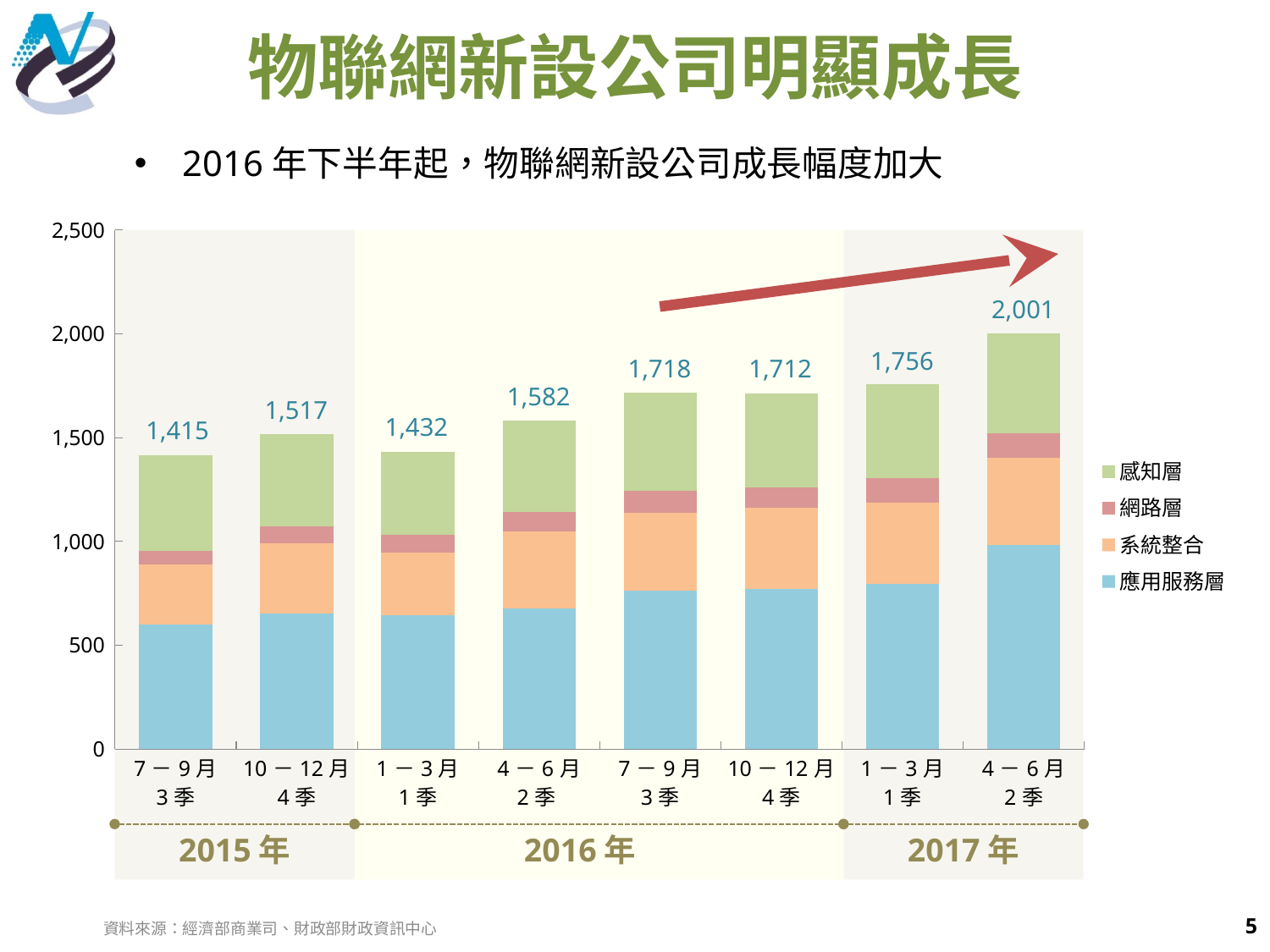
Which quarter has the highest total value? 2017 年 2 季 (4－6月) Which quarter has the lowest total value? 2015 年 3 季 (7－9月) Is the 應用服務層 value for 2015 年 3 季 (7－9月) greater or less than 500? greater What is the difference between the total for 2017 年 2 季 and the total for 2017 年 1 季? 245 What kind of chart is shown on the slide? Stacked bar chart How many quarterly bars are shown in the chart? 8 What is the total value labelled for the 2017 年 2 季 (4－6月) bar? 2,001 How many series does the legend list? 4 Which is larger, the total for 2016 年 3 季 (7－9月) or the total for 2016 年 4 季 (10－12月)? 2016 年 3 季 (7－9月) What is the total value labelled for the 2015 年 3 季 (7－9月) bar? 1,415 What is the total value labelled for the 2016 年 2 季 (4－6月) bar? 1,582 Which series is shown at the bottom of each stacked bar? 應用服務層